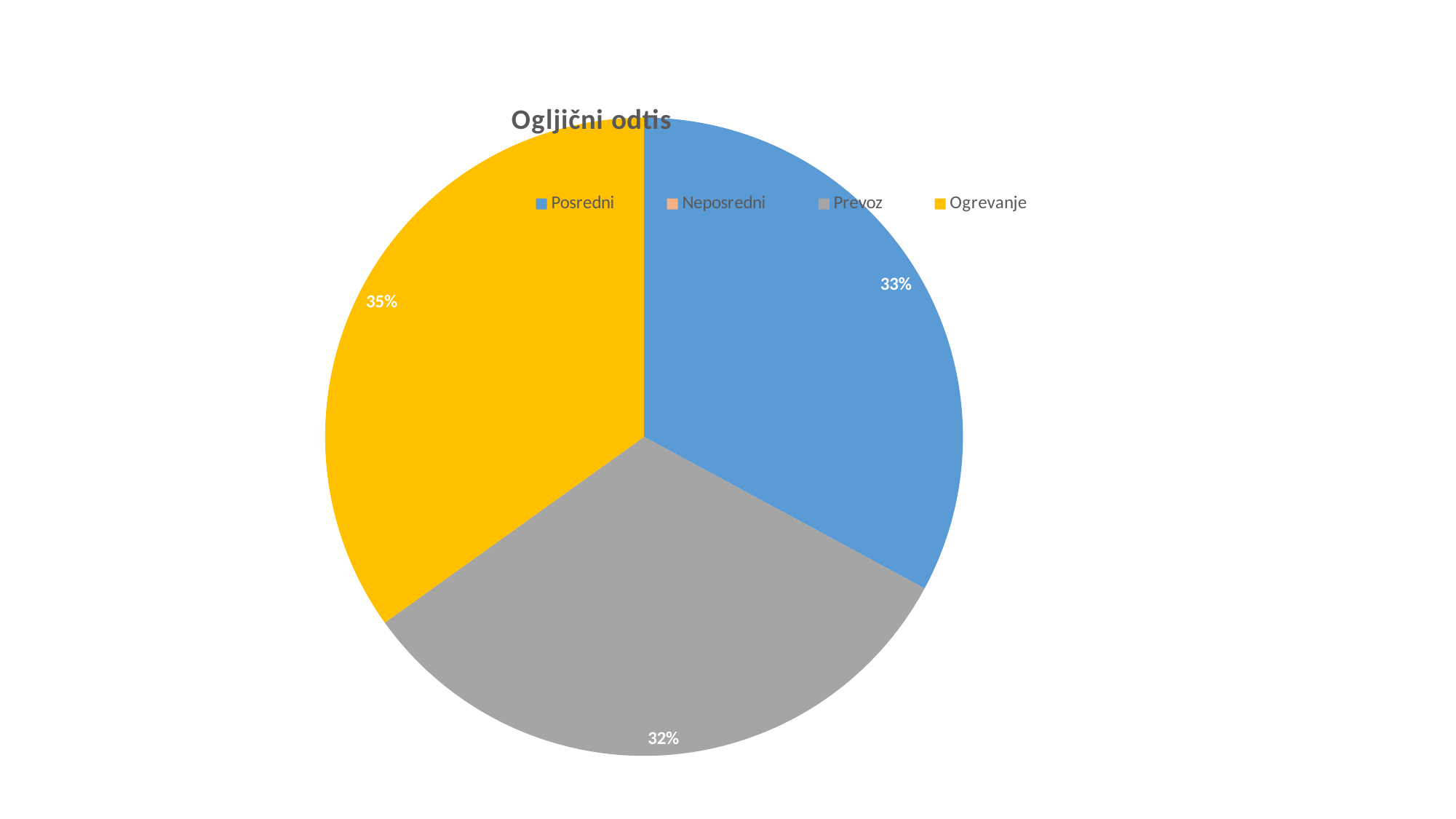
Which is larger, the share for Ogrevanje or the share for Posredni? Ogrevanje What share of the pie does Posredni have? 33% What is the difference in percentage points between the Ogrevanje share and the Prevoz share? 3 What kind of chart is shown on the slide? Pie chart What share of the pie does Prevoz have? 32% What colour is the Ogrevanje slice? Yellow What is the difference in percentage points between the Ogrevanje share and the Posredni share? 2 What share of the pie does Ogrevanje have? 35% How many entries does the legend list? 4 What is the title of the chart? Ogljični odtis Which is larger, the share for Posredni or the share for Prevoz? Posredni Which category has the largest slice of the pie? Ogrevanje